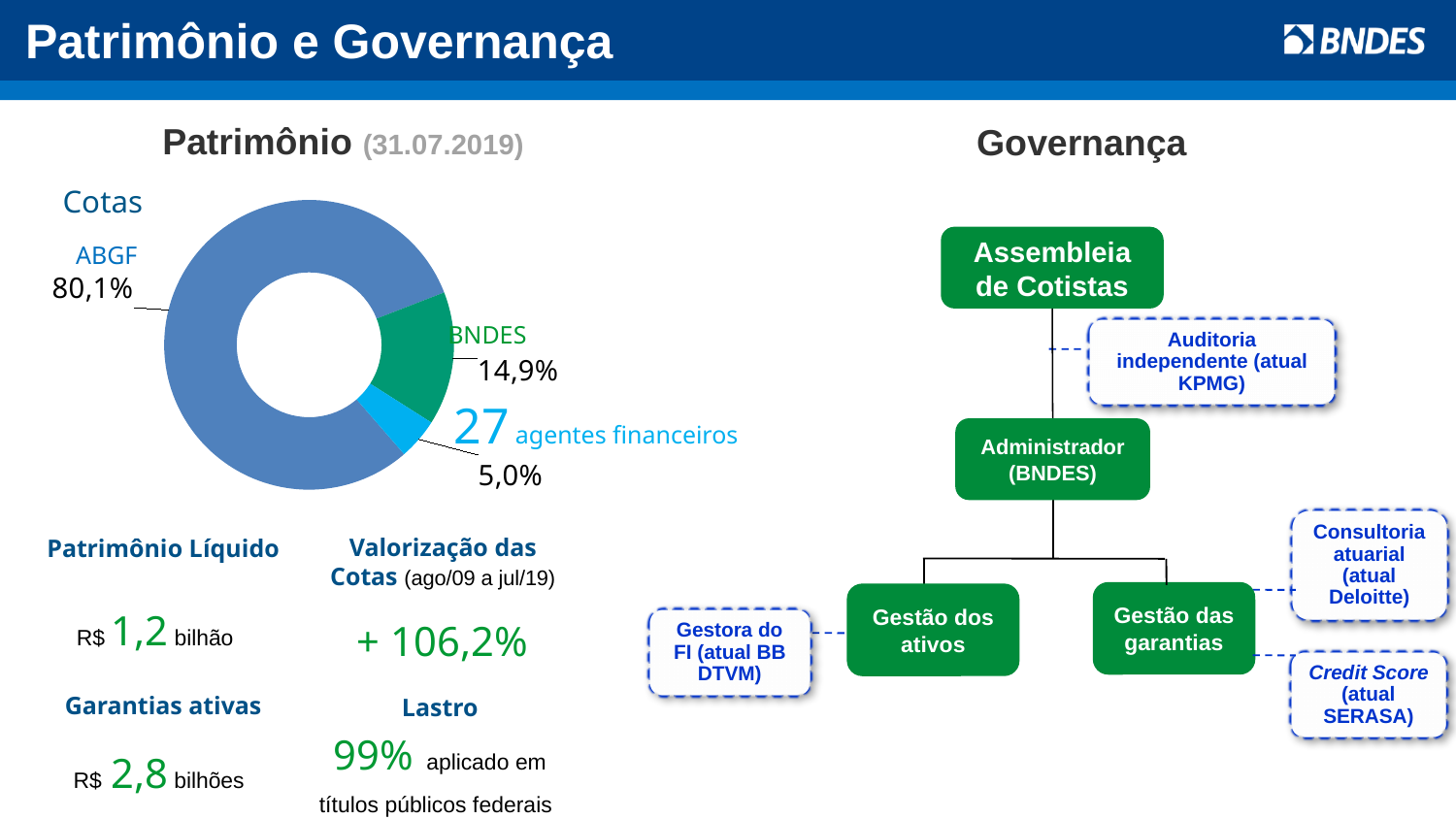
In the "Cotas" chart, which share is larger: BNDES or the 27 agentes financeiros? BNDES In the "Cotas" chart, what is the difference in percentage points between the ABGF share and the BNDES share? 65,2 percentage points In the "Cotas" chart, which holder has the largest share? ABGF What kind of chart is the "Cotas" chart on the slide? Donut (pie) chart In the "Cotas" chart, how many slices are shown? 3 In the "Cotas" chart, how many financial agents (agentes financeiros) share the 5,0% slice? 27 In the "Cotas" chart, what colour is the BNDES slice? Green In the "Cotas" chart, what share of the quotas is held by the 27 agentes financeiros? 5,0% In the "Cotas" chart, what share of the quotas is held by ABGF? 80,1% In the "Cotas" chart, which holder has the smallest share? 27 agentes financeiros In the "Cotas" chart, what share of the quotas is held by BNDES? 14,9% In the "Cotas" chart, what is the difference in percentage points between the BNDES share and the 27 agentes financeiros share? 9,9 percentage points